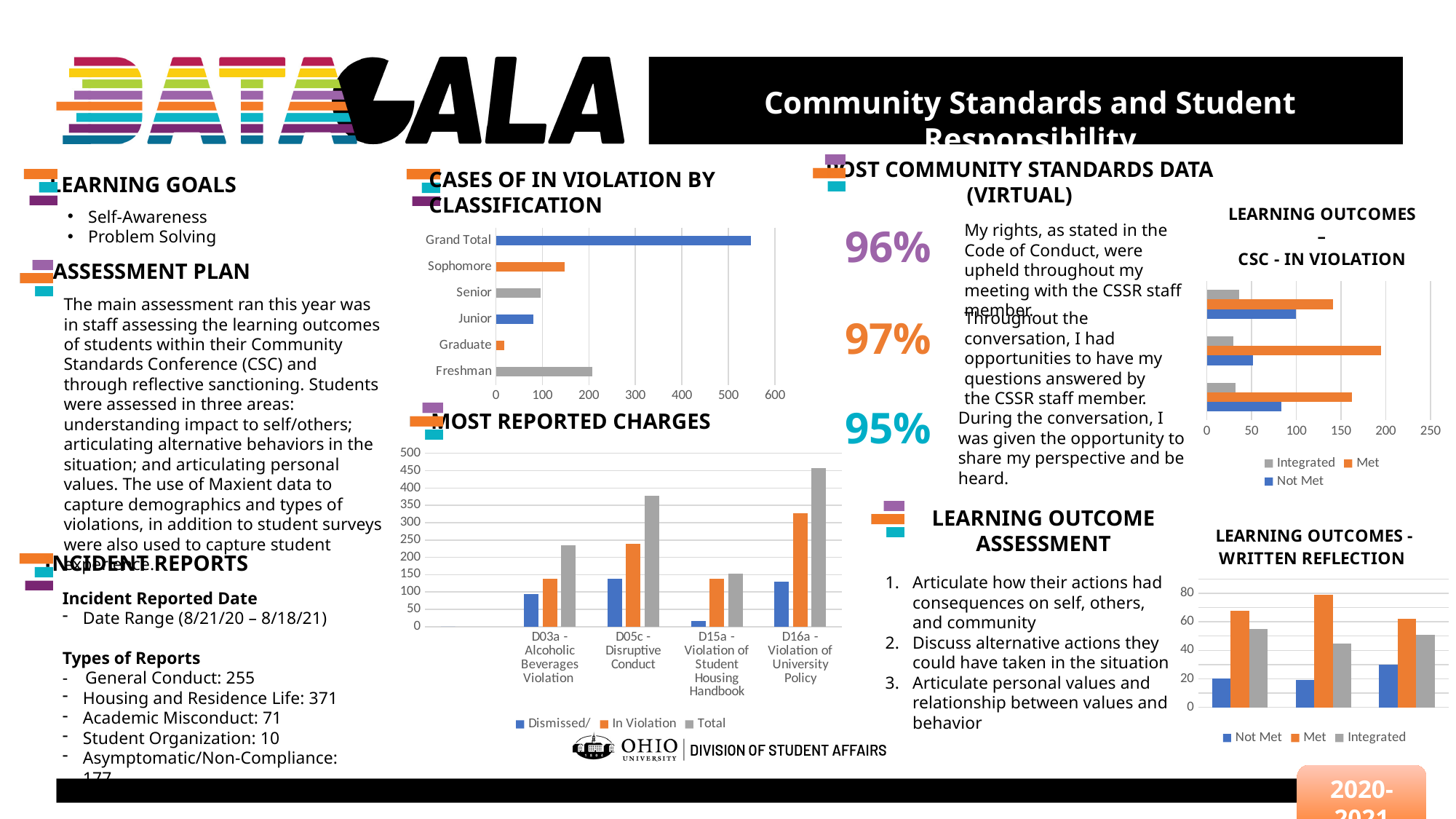
How many series does the legend of the 'Most Reported Charges' chart list? 3 In the 'Cases of In Violation by Classification' chart, which is larger, the value for Freshman or the value for Senior? Freshman In the 'Most Reported Charges' chart, which category has the highest Total value? D16a - Violation of University Policy In the 'Cases of In Violation by Classification' chart, which category has the lowest value? Graduate In the 'Most Reported Charges' chart, is the Total value for D16a - Violation of University Policy greater or less than 400? greater In the 'Cases of In Violation by Classification' chart, which category has the highest value? Grand Total What are the legend entries of the 'Learning Outcomes - Written Reflection' chart? Not Met, Met, Integrated In the 'Cases of In Violation by Classification' chart, is the value for Sophomore greater or less than 100? greater How many categories are shown in the 'Cases of In Violation by Classification' chart? 6 In the 'Cases of In Violation by Classification' chart, is the value for Grand Total greater or less than 500? greater In the 'Most Reported Charges' chart, which category has the lowest Dismissed/ value? D15a - Violation of Student Housing Handbook What type of chart is the 'Cases of In Violation by Classification' chart? bar chart